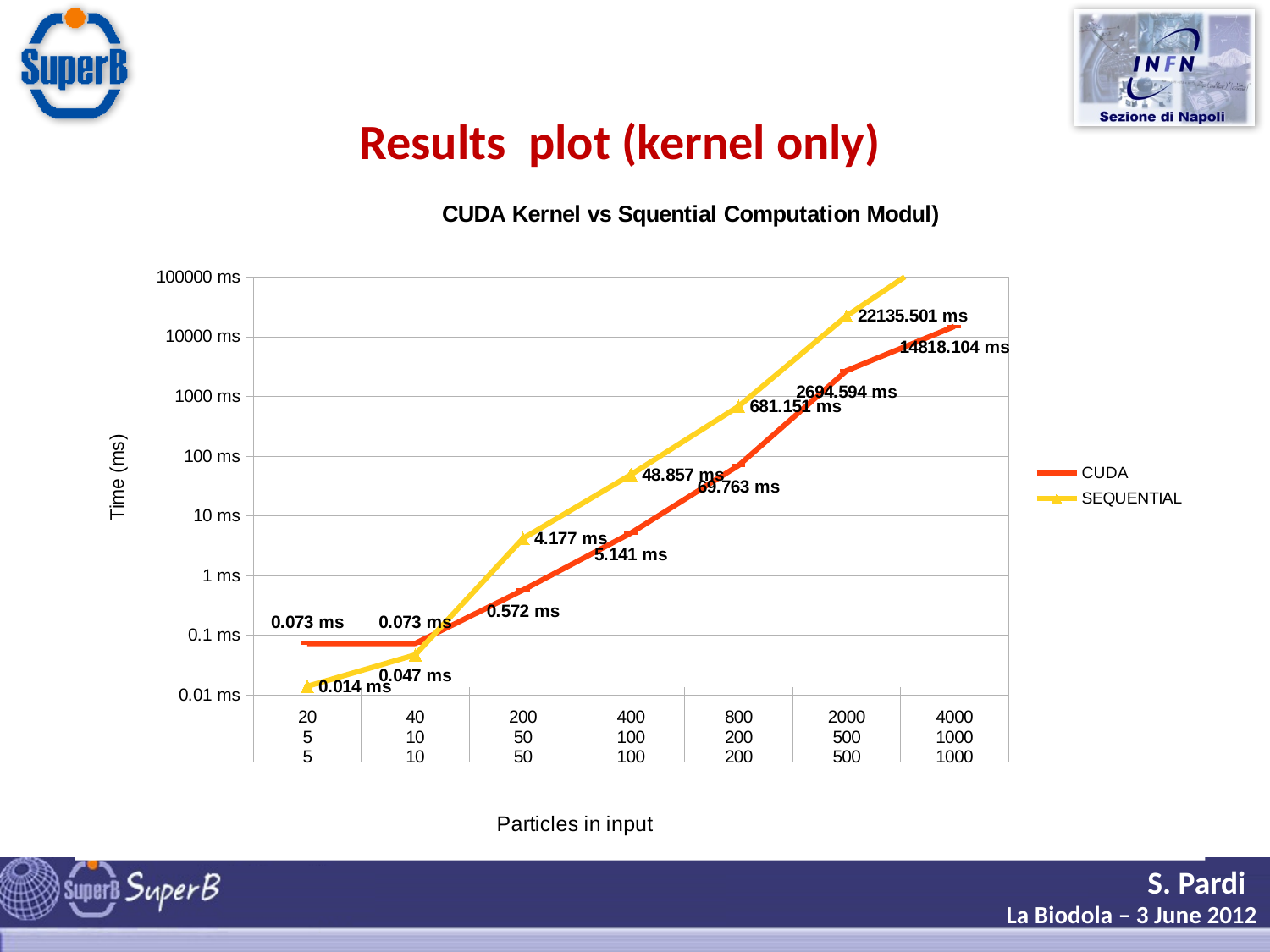
At which x-axis category is the SEQUENTIAL time lowest? 20 How many x-axis categories (particle input sizes) are plotted? 7 What kind of chart is shown on the slide? line chart What is the CUDA time at the x-axis category labelled 200? 0.572 ms What is the SEQUENTIAL time at the x-axis category labelled 800? 681.151 ms What is the difference between the SEQUENTIAL and CUDA times at the x-axis category labelled 400? 43.716 ms At the x-axis category labelled 2000, which series has the larger time, CUDA or SEQUENTIAL? SEQUENTIAL What is the CUDA time at the x-axis category labelled 4000? 14818.104 ms How many series does the legend list? 2 At the x-axis category labelled 20, which series has the larger time, CUDA or SEQUENTIAL? CUDA Is the SEQUENTIAL value at the x-axis category labelled 4000 greater or less than 10000 ms? greater What is the title of the y-axis? Time (ms)